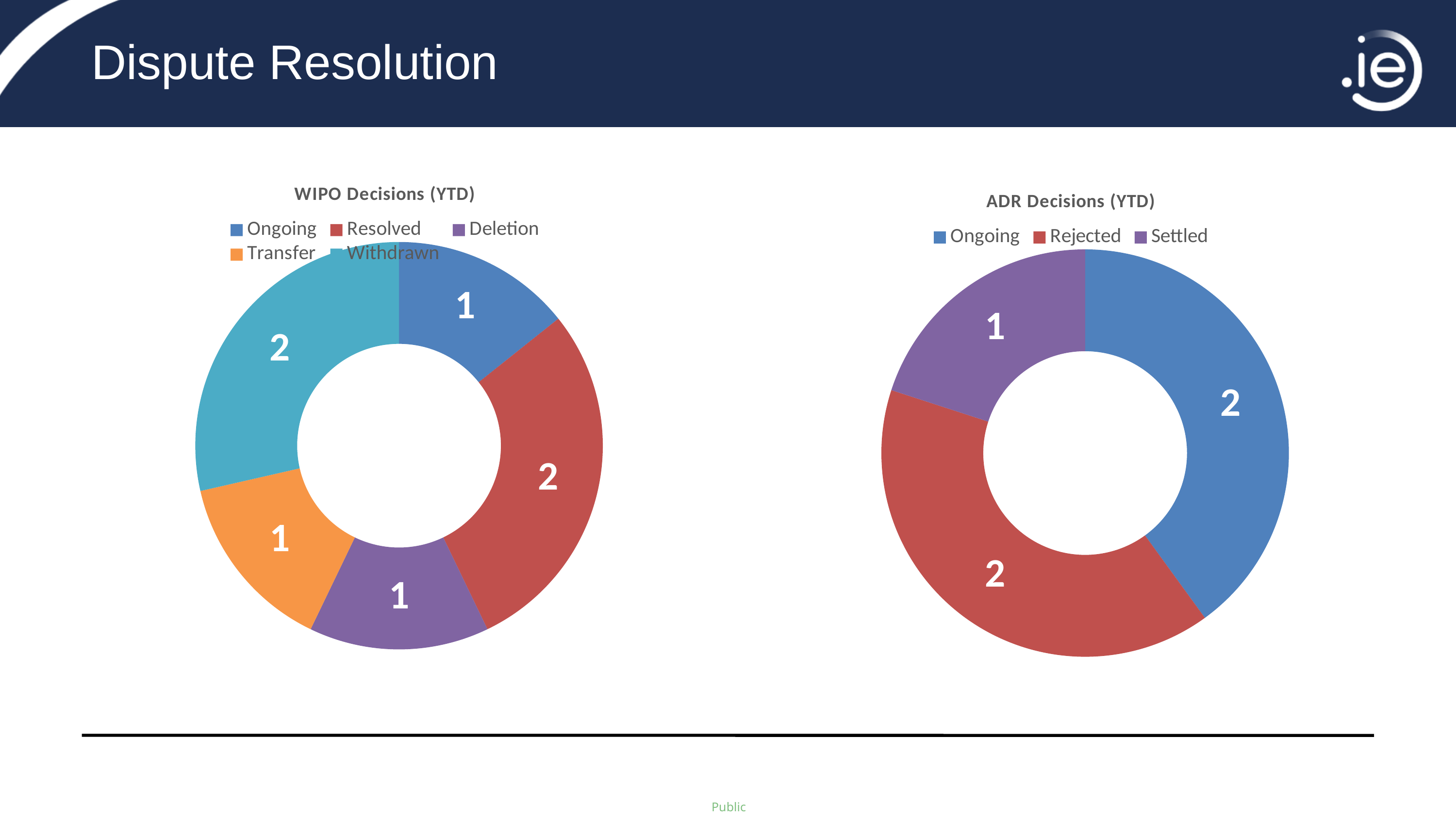
How many categories does the WIPO Decisions (YTD) chart show? 5 In the ADR Decisions (YTD) chart, what share of the total does Settled represent? 20% In the WIPO Decisions (YTD) chart, which is larger, Resolved or Ongoing? Resolved In the ADR Decisions (YTD) chart, which is larger, Ongoing or Settled? Ongoing How many categories does the ADR Decisions (YTD) chart show? 3 In the WIPO Decisions (YTD) chart, what is the difference between the Withdrawn and Deletion values? 1 In the WIPO Decisions (YTD) chart, what is the value for Transfer? 1 In the ADR Decisions (YTD) chart, what is the value for Rejected? 2 What is the total of all values in the ADR Decisions (YTD) chart? 5 In the WIPO Decisions (YTD) chart, what is the value for Resolved? 2 In the ADR Decisions (YTD) chart, what is the value for Settled? 1 In the ADR Decisions (YTD) chart, which category has the lowest value? Settled